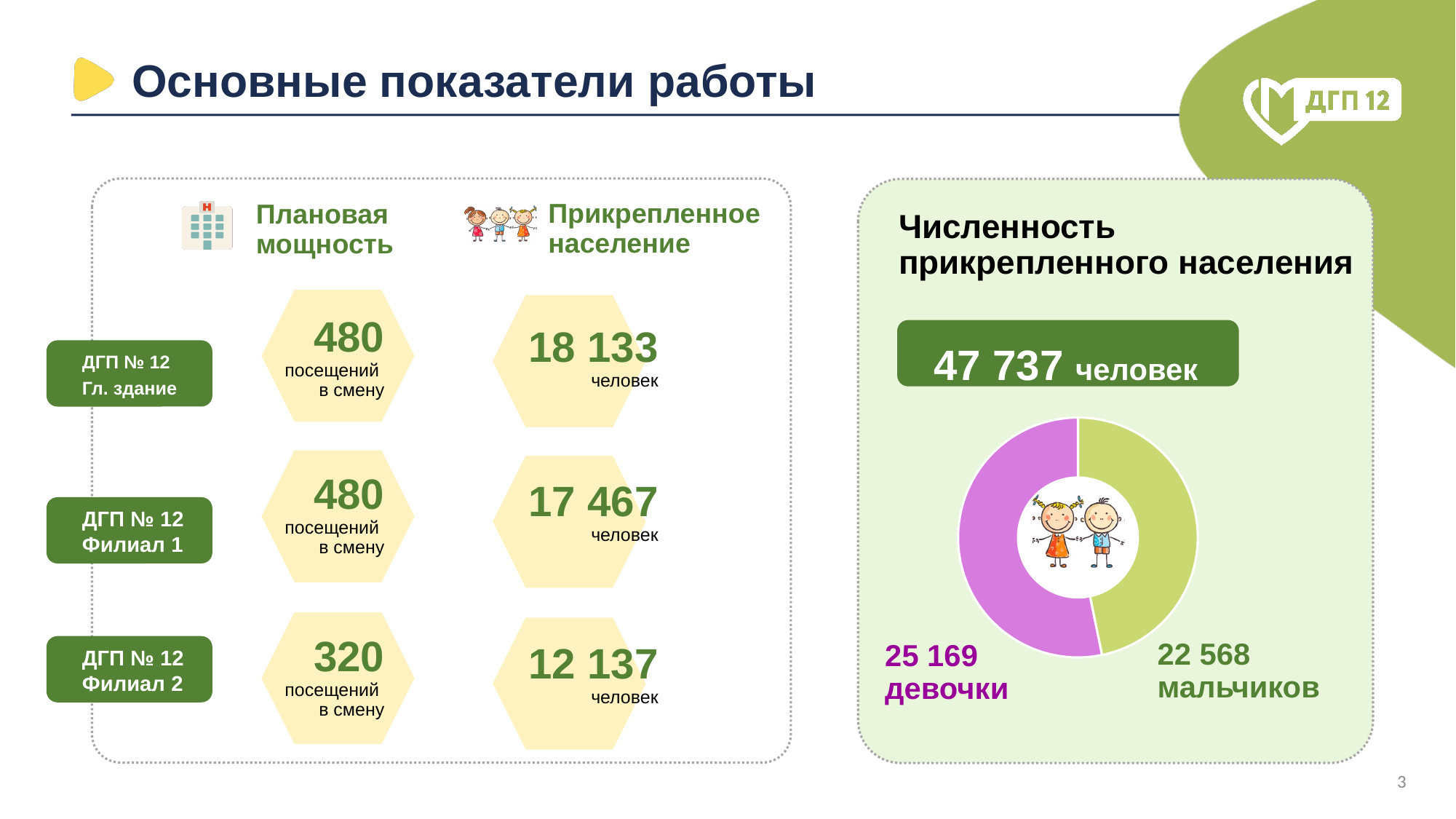
What kind of chart is shown in the "Численность прикрепленного населения" panel? Pie (donut) chart How many segments does the donut chart have? 2 What colour is the "мальчиков" segment of the donut chart? Green What colour is the "девочки" segment of the donut chart? Pink (magenta) Which segment of the donut chart is larger, девочки or мальчиков? девочки In the donut chart, how many people are in the "девочки" segment? 25 169 In the donut chart, how many people are in the "мальчиков" segment? 22 568 Is the number of мальчиков in the donut chart greater or less than the number of девочки? less What is the total number of people represented by the donut chart? 47 737 человек By how much does the number of девочки exceed the number of мальчиков in the donut chart? 2 601 Which segment of the donut chart is the smallest? мальчиков